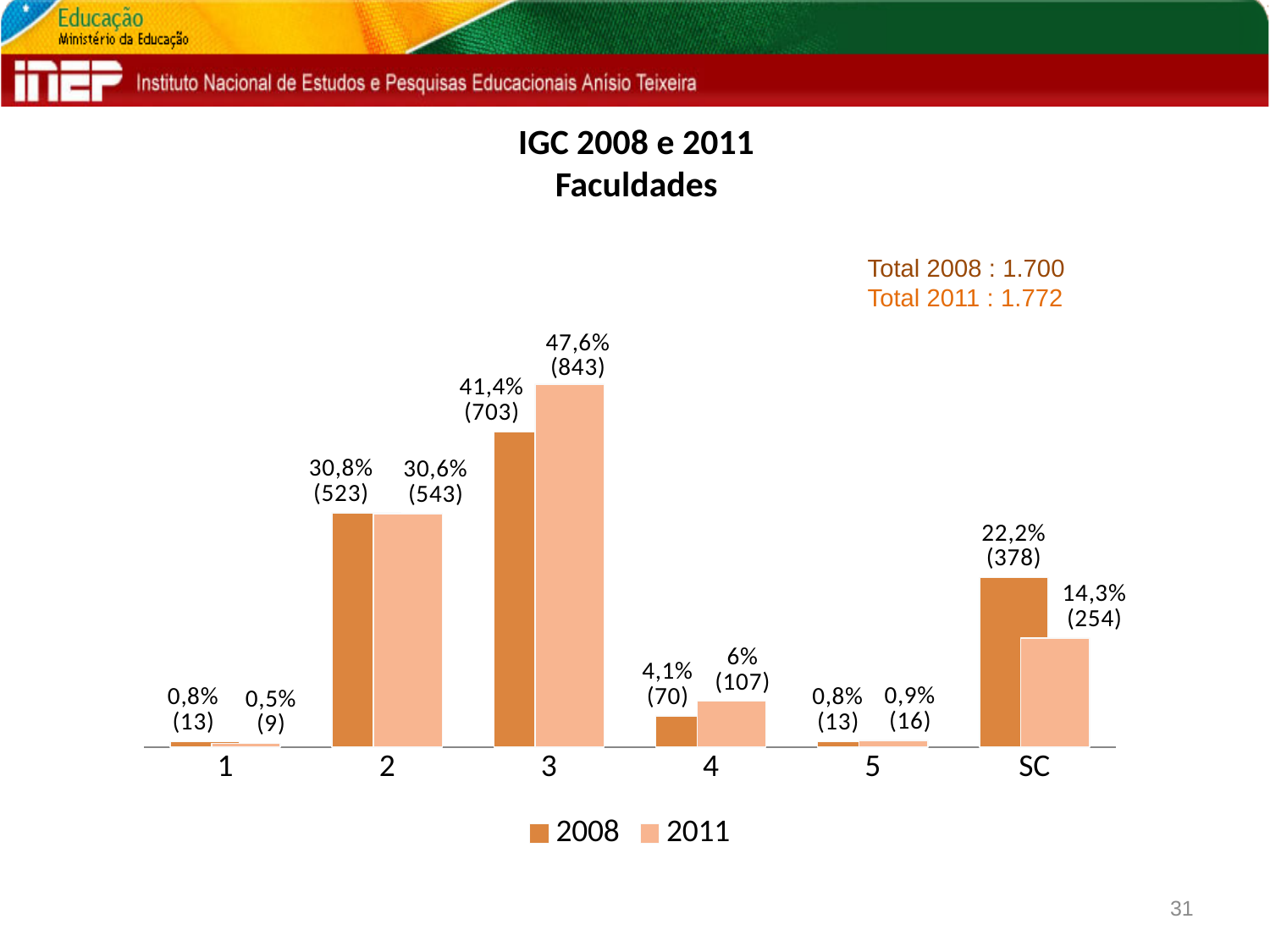
What is the value for category 2 in the 2008 series? 30,8% (523) Which category has the highest value in the 2008 series? 3 What is the value for category 3 in the 2011 series? 47,6% (843) What is the difference in count between 2011 and 2008 for category 4? 37 What is the title of the chart? IGC 2008 e 2011 Faculdades What kind of chart is shown on the slide? bar chart How many categories are shown on the x axis? 6 What is the value for SC in the 2011 series? 14,3% (254) Which category has the lowest value in the 2011 series? 1 What is the total for 2011 shown on the slide? 1.772 How many series does the legend list? 2 Which is larger for SC: the 2008 value or the 2011 value? 2008